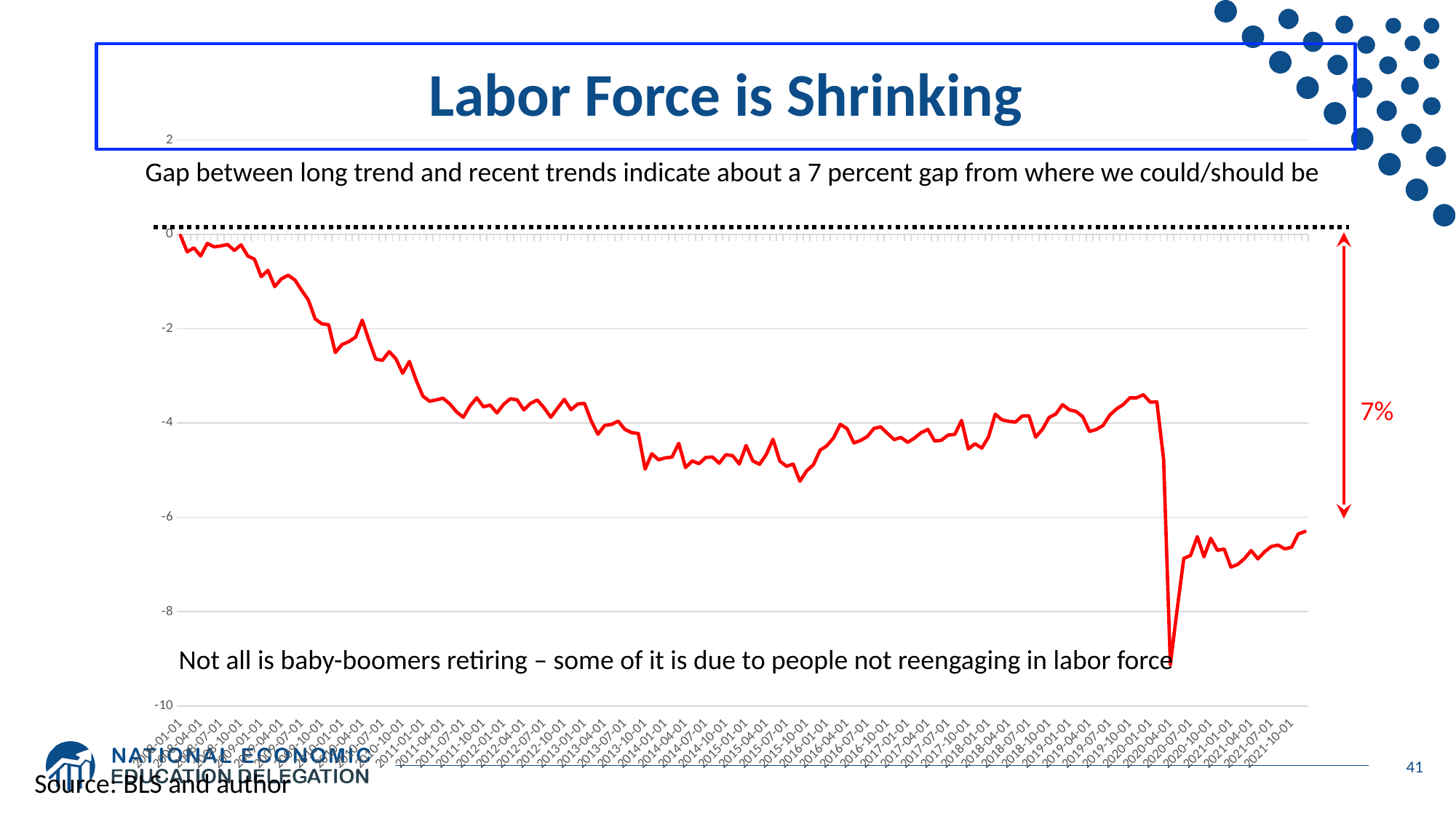
Overall, does the red line rise or fall from 2008 to 2021? fall What percentage gap is marked by the red double-headed arrow on the right of the chart? 7% What is the lowest value shown on the y axis? -10 Is the value at the lowest point of the line (around 2020-04-01) greater or less than -8? less Which is larger, the value around 2008-01-01 or the value around 2021-10-01? 2008-01-01 Is the value around 2016-01-01 greater or less than -4? less Is the value around 2019-10-01 greater or less than -4? greater What is the title of the chart on the slide? Labor Force is Shrinking What kind of chart is shown on the slide? line chart Around which date does the red line reach its lowest point? 2020-04-01